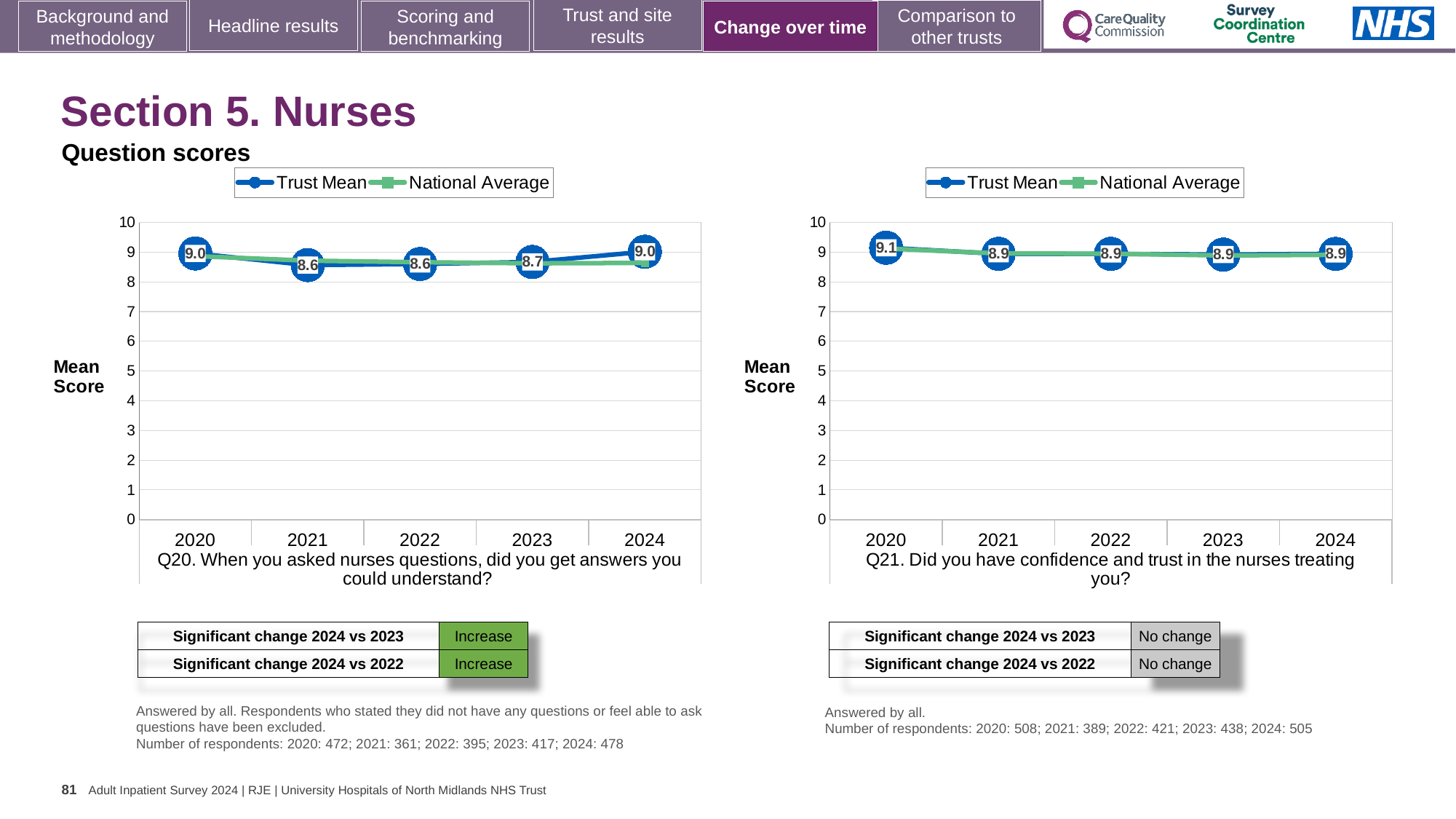
In the Q20 chart (left), what is the Trust Mean score for 2024? 9.0 How many series does the legend of the Q21 chart (right) list? 2 In the Q20 chart (left), does the Trust Mean score rise or fall from 2023 to 2024? Rise In the Q21 chart (right), what is the Trust Mean score for 2020? 9.1 How many years are plotted on the x axis of the Q20 chart (left)? 5 In the Q21 chart (right), what is the Trust Mean score for 2023? 8.9 In the Q21 chart (right), what is the difference between the Trust Mean scores for 2020 and 2024? 0.2 In the Q20 chart (left), what is the difference between the Trust Mean scores for 2024 and 2023? 0.3 What kind of chart is the Q20 chart (left)? Line chart In the Q20 chart (left), what is the Trust Mean score for 2021? 8.6 In the Q21 chart (right), is the Trust Mean score for 2022 greater or less than 8? greater In the Q20 chart (left), which year has the lowest Trust Mean score, 2021 or 2023? 2021